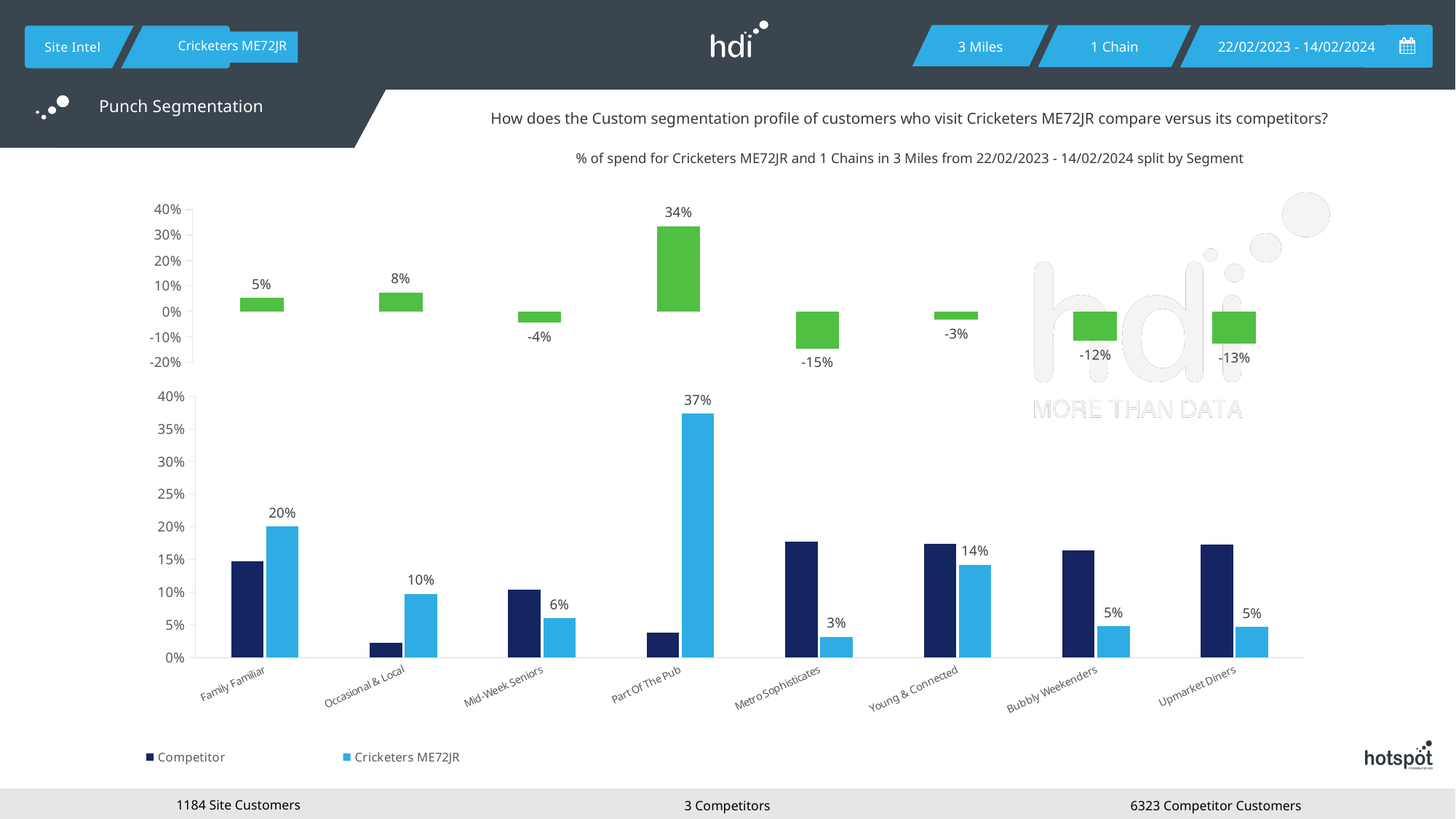
In the top chart, what is the value for Metro Sophisticates? -15% In the top chart, what is the value for Occasional & Local? 8% In the bottom chart, what is the Cricketers ME72JR value for Part Of The Pub? 37% In the top chart, which segment has the lowest value? Metro Sophisticates How many segments are shown on the x axis of the bottom chart? 8 In the bottom chart, which segment has the lowest Cricketers ME72JR value? Metro Sophisticates In the bottom chart, what is the Cricketers ME72JR value for Family Familiar? 20% In the bottom chart, is the Competitor value for Occasional & Local greater or less than 5%? less In the bottom chart, is the Competitor value for Metro Sophisticates greater or less than 15%? greater In the bottom chart, what is the difference between the Cricketers ME72JR values for Family Familiar and Young & Connected? 6% In the top chart, which segment has the highest value? Part Of The Pub How many series does the legend of the bottom chart list? 2